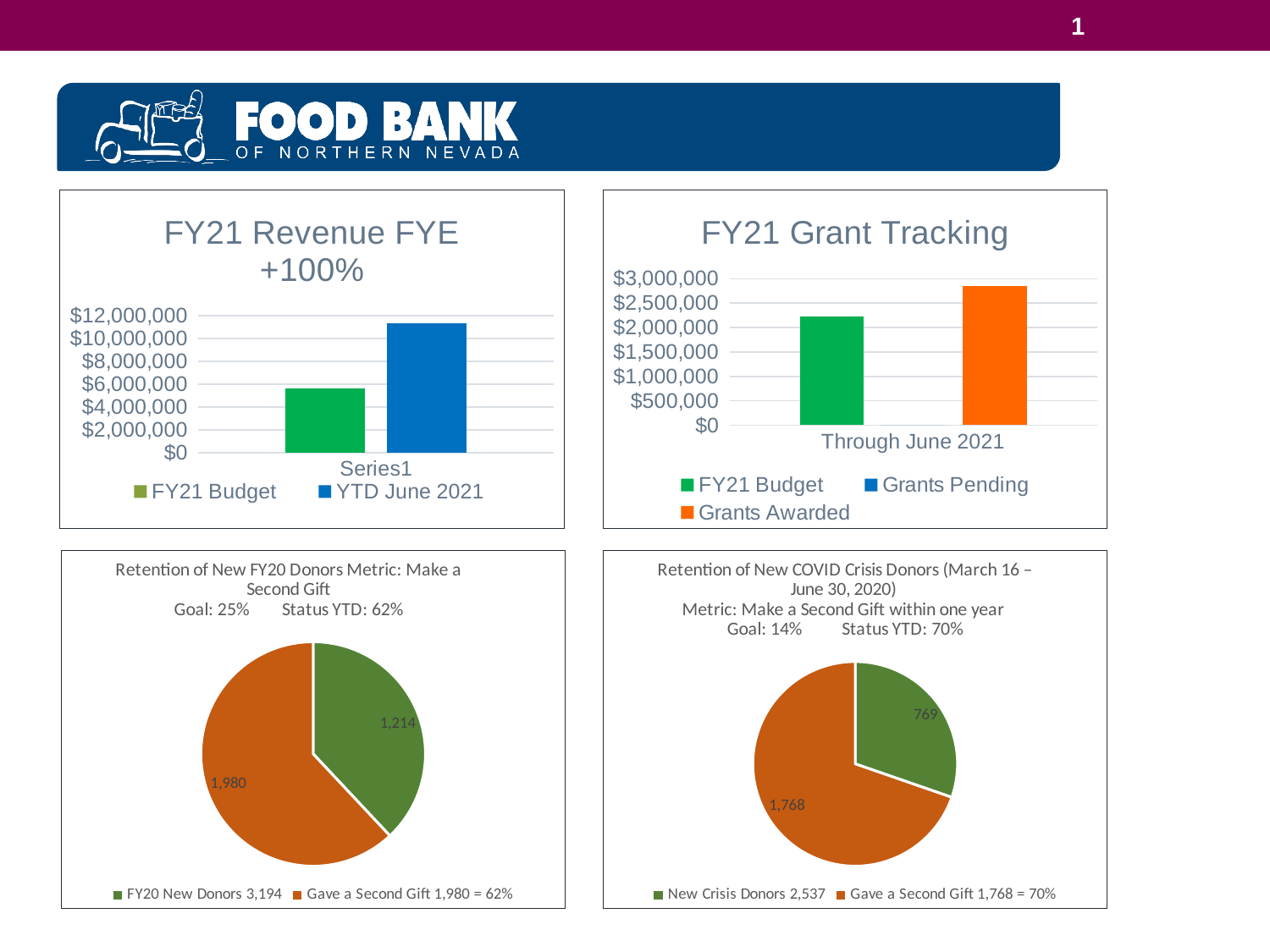
In the 'FY21 Revenue FYE +100%' chart, how many series does the legend list? 2 In the 'Retention of New FY20 Donors' pie chart, what is the value of the 'Gave a Second Gift' slice? 1,980 In the 'FY21 Revenue FYE +100%' chart, which is larger, FY21 Budget or YTD June 2021? YTD June 2021 In the 'Retention of New COVID Crisis Donors' pie chart, what share of donors gave a second gift, as shown in the legend? 70% In the 'FY21 Grant Tracking' chart, what is the category label on the x axis? Through June 2021 In the 'FY21 Revenue FYE +100%' chart, is the value for FY21 Budget greater or less than $6,000,000? less In the 'FY21 Grant Tracking' chart, is the value for Grants Awarded greater or less than $2,500,000? greater In the 'FY21 Grant Tracking' chart, how many series does the legend list? 3 What kind of chart is the 'FY21 Revenue FYE +100%' chart? bar chart In the 'Retention of New COVID Crisis Donors' pie chart, what is the value of the smaller slice? 769 In the 'FY21 Grant Tracking' chart, which is larger, FY21 Budget or Grants Awarded? Grants Awarded In the 'Retention of New FY20 Donors' pie chart, what is the difference between the two slice values, 1,980 and 1,214? 766